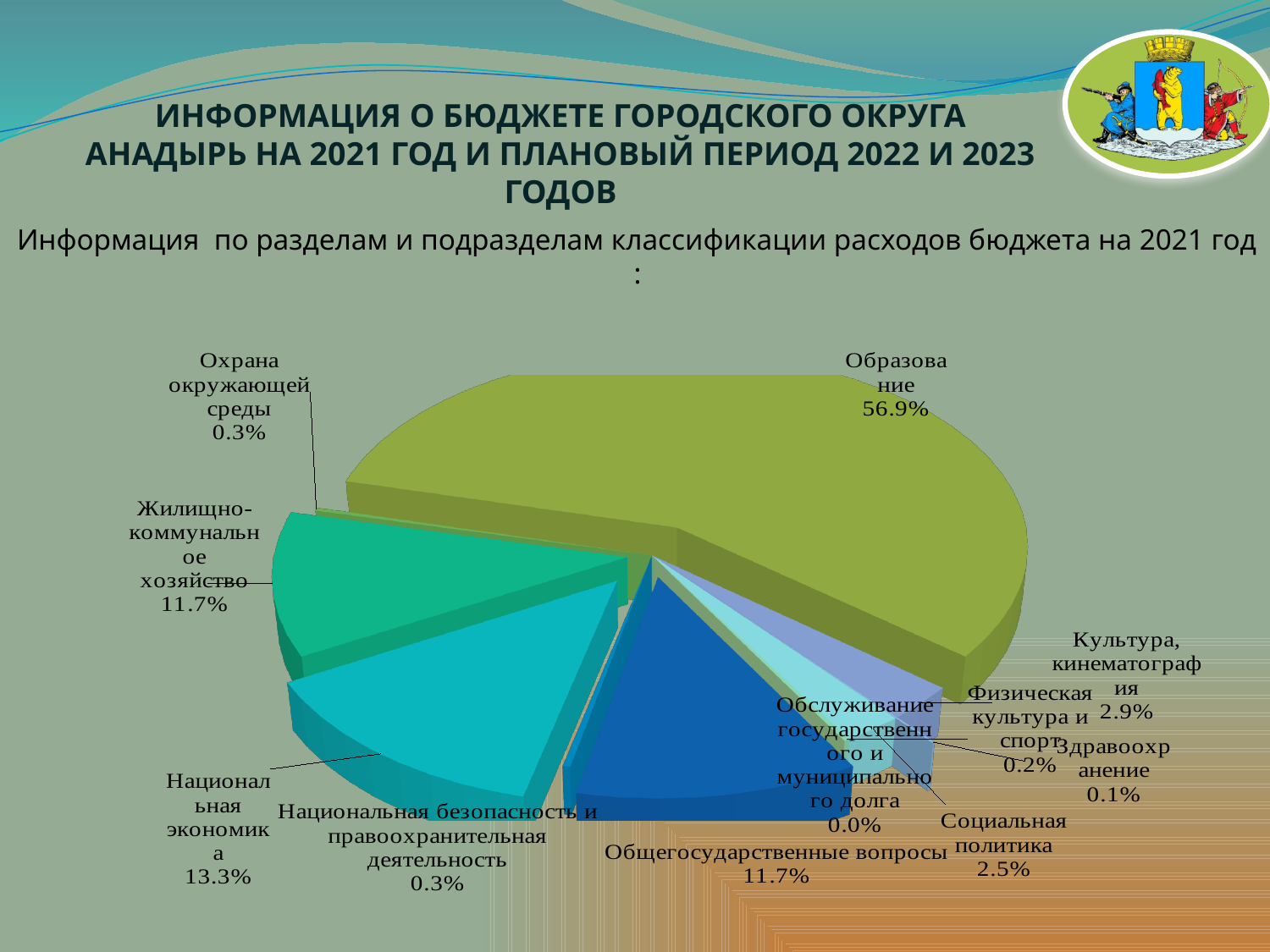
Which category has the smallest share of the pie? Обслуживание государственного и муниципального долга Which is larger, the share for Национальная экономика or the share for Общегосударственные вопросы? Национальная экономика What is the value shown for Культура, кинематография? 2.9% What is the value shown for Жилищно-коммунальное хозяйство? 11.7% What kind of chart is shown on the slide? pie chart What is the value shown for Здравоохранение? 0.1% How many categories are shown in the pie chart? 11 What share of the pie does Образование have? 56.9% What is the value shown for Социальная политика? 2.5% Which category has the largest share of the pie? Образование What is the difference between the shares of Образование and Национальная экономика? 43.6% What is the value shown for Национальная экономика? 13.3%